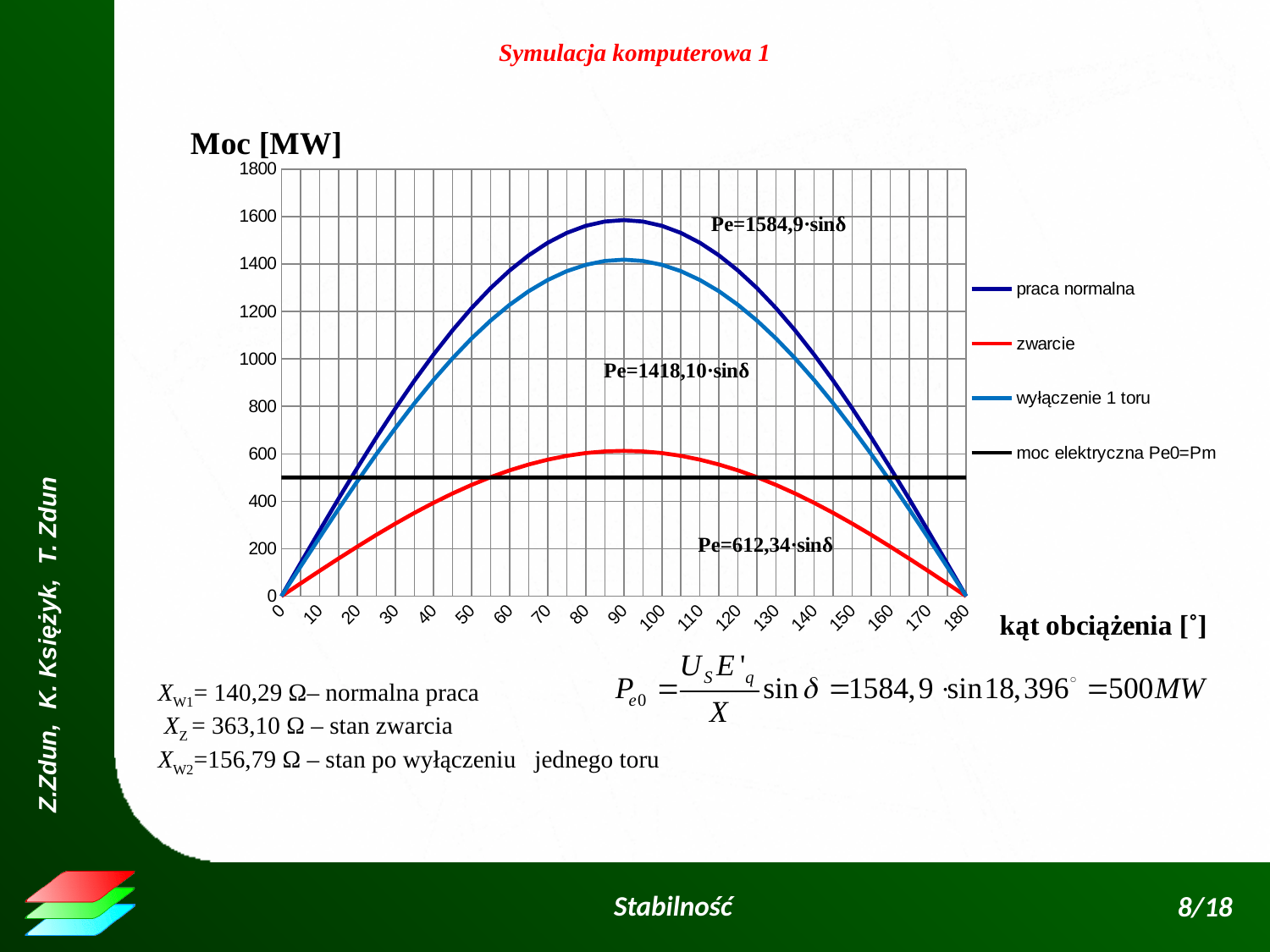
Is the value of zwarcie at 90° greater or less than 800? less Is the horizontal line moc elektryczna Pe0=Pm greater or less than 400? greater What is the label of the vertical axis? Moc [MW] At 90°, which is larger: praca normalna or zwarcie? praca normalna Which of the three curves has the lowest peak value? zwarcie What is the label of the horizontal axis? kąt obciążenia [˚] Is the value of praca normalna at 90° greater or less than 1400? greater What type of chart is shown on the slide? line chart According to the label on the chart, what is the peak value (at δ=90°) of the wyłączenie 1 toru curve? 1418,10 How many series does the legend list? 4 How does the praca normalna curve change as the angle goes from 90° to 180°? falls Which series reaches the highest peak value? praca normalna